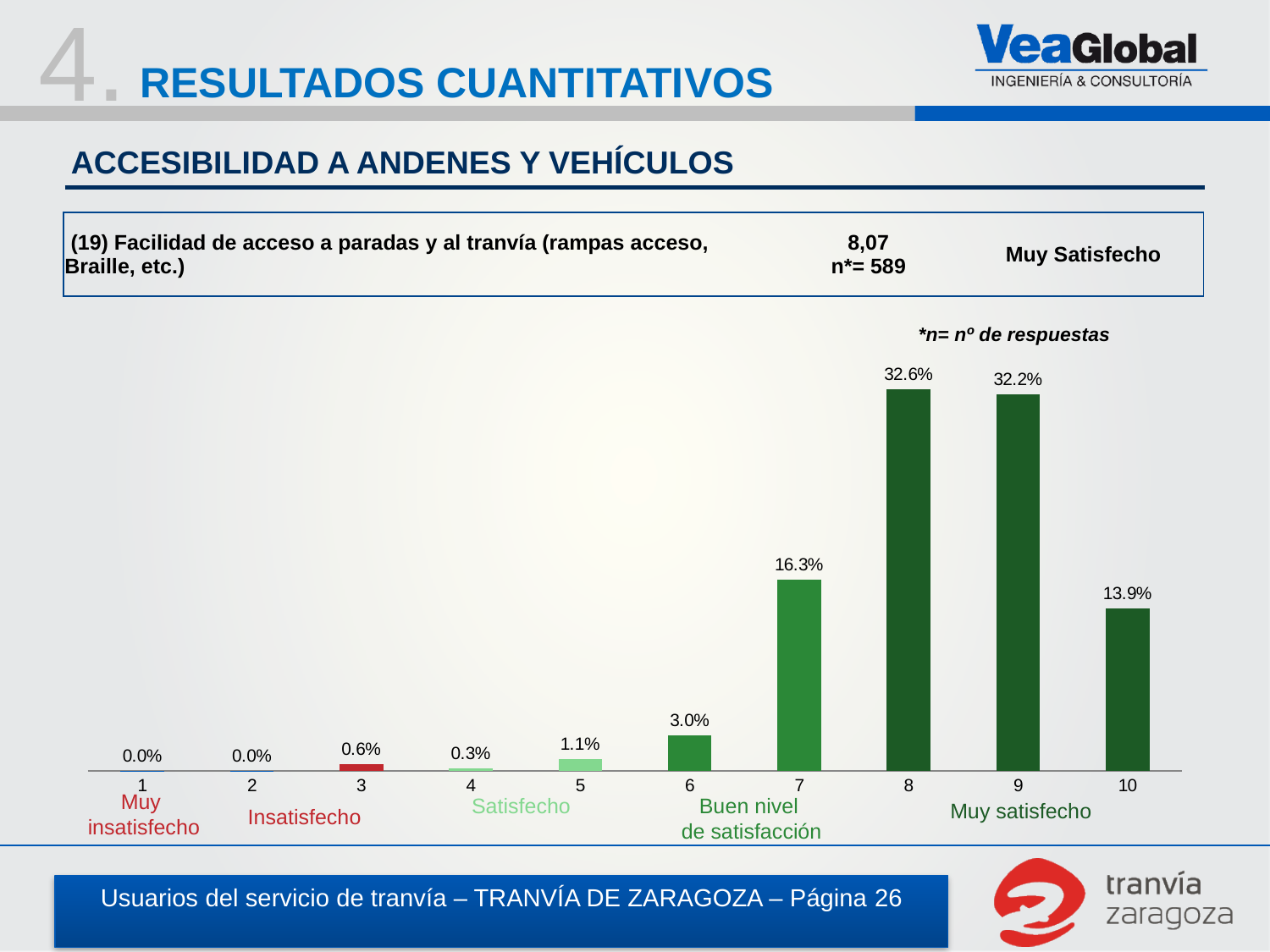
What kind of chart is shown on the slide? bar chart What is the difference between the values for categories 8 and 9? 0.4% What is the value for category 6? 3.0% What is the difference between the values for categories 7 and 10? 2.4% Which is larger, the value for category 7 or the value for category 6? 7 How many categories are shown on the x axis? 10 What is the value for category 8? 32.6% What is the value for category 10? 13.9% What is the value for category 5? 1.1% What is the combined value of categories 8 and 9? 64.8% Which category has the highest value? 8 What colour are the bars for categories 1 to 3? red